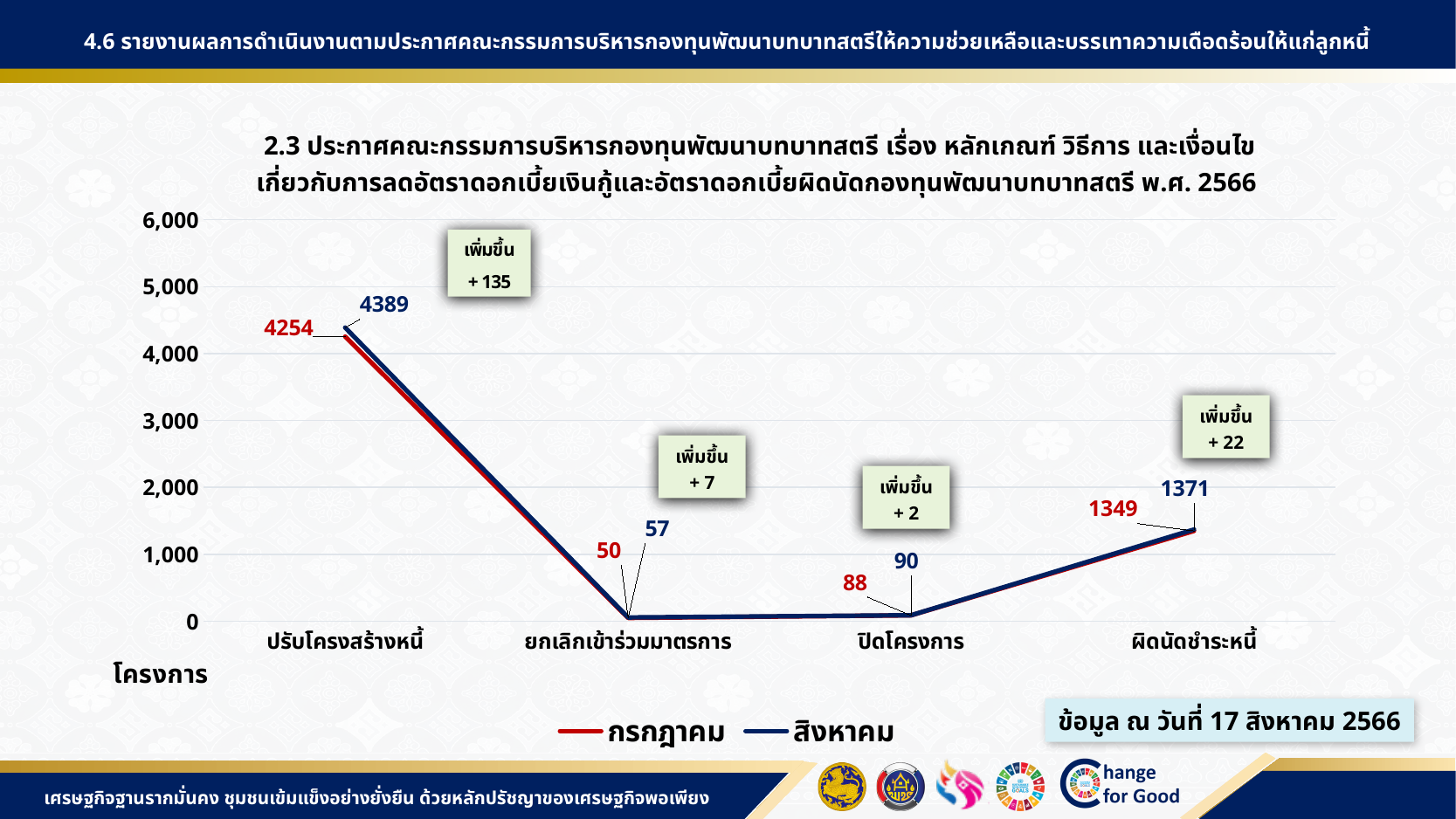
What type of chart is shown on the slide? line chart Which category has the lowest value in the กรกฎาคม series? ยกเลิกเข้าร่วมมาตรการ How many series does the legend list? 2 What is the value for ปรับโครงสร้างหนี้ in the สิงหาคม series? 4389 Which category has the highest value in the สิงหาคม series? ปรับโครงสร้างหนี้ Which is larger for ยกเลิกเข้าร่วมมาตรการ: the กรกฎาคม value or the สิงหาคม value? สิงหาคม How many categories are shown on the x axis? 4 What is the value for ปรับโครงสร้างหนี้ in the กรกฎาคม series? 4254 Which series is drawn in red in the legend? กรกฎาคม What is the difference between the สิงหาคม and กรกฎาคม values for ผิดนัดชำระหนี้? 22 What is the value for ปิดโครงการ in the สิงหาคม series? 90 What is the value for ผิดนัดชำระหนี้ in the กรกฎาคม series? 1349